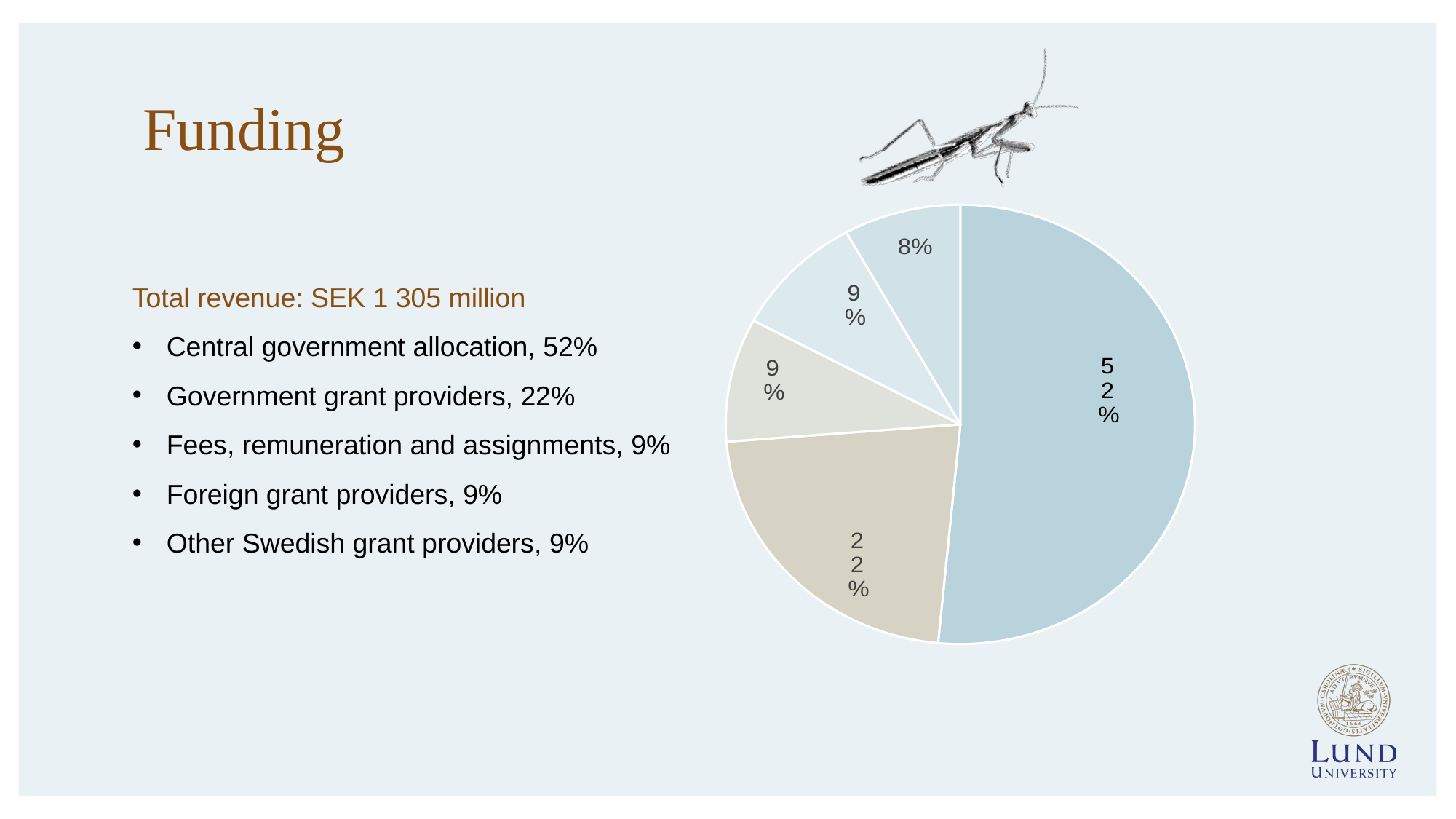
What is the title of the slide containing the pie chart? Funding How many slices does the pie chart have? 5 According to the slide, what share of funding comes from Central government allocation? 52% Which is larger in the pie chart: the 22% slice or the 8% slice? the 22% slice What kind of chart is shown on the slide? pie chart What is the value of the smallest slice in the pie chart? 8% Does the largest slice of the pie chart account for more or less than half of the total? more What is the value of the largest slice in the pie chart? 52% How many slices in the pie chart are labelled 9%? 2 What is the difference between the largest slice (52%) and the second-largest slice (22%) in the pie chart? 30% According to the slide, what share of funding comes from Government grant providers? 22% What is the value of the second-largest slice in the pie chart? 22%